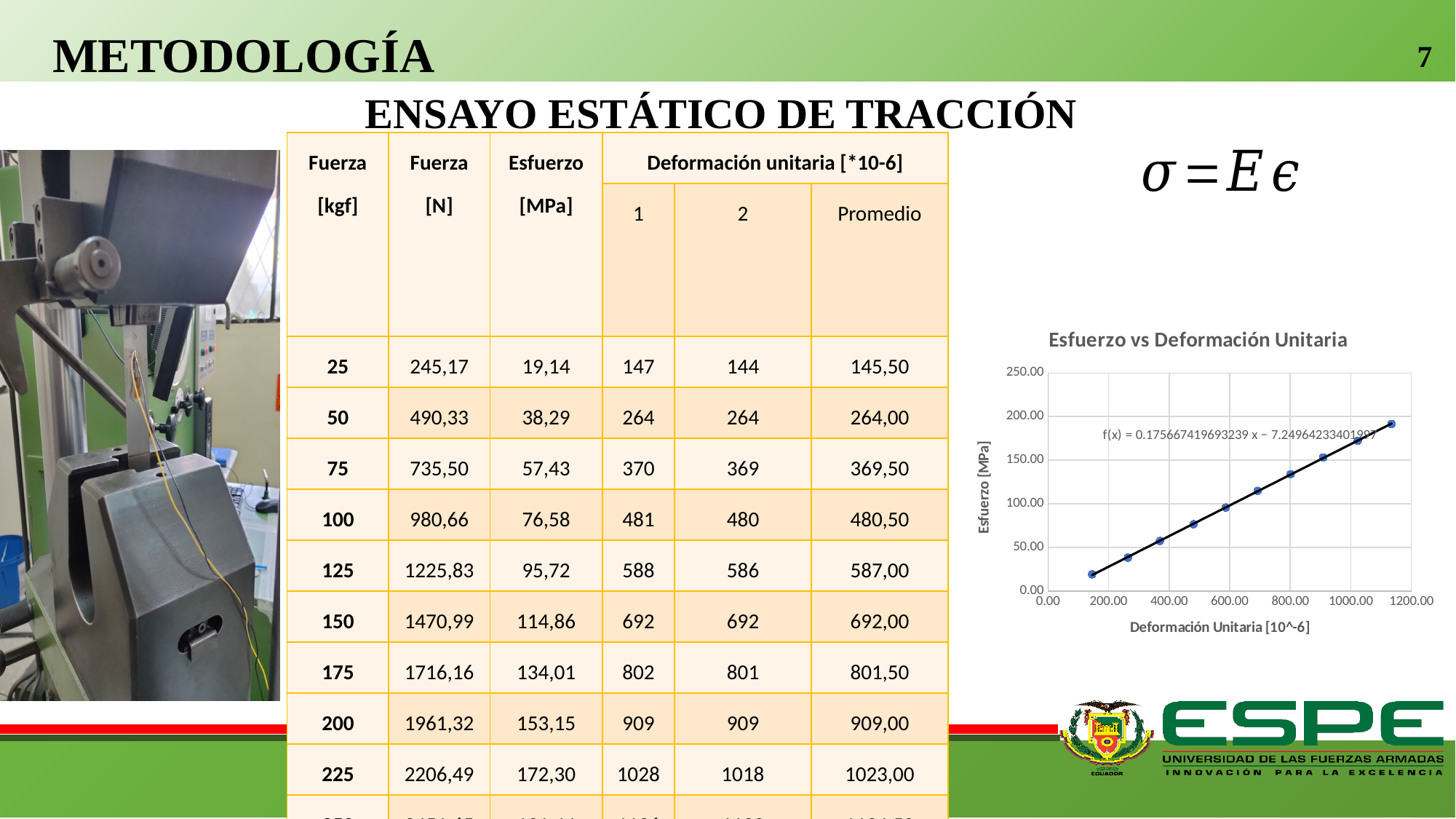
In the Esfuerzo vs Deformación Unitaria chart, is the esfuerzo of the highest point greater or less than 200? less What is the highest tick value shown on the vertical axis of the Esfuerzo vs Deformación Unitaria chart? 250.00 In the Esfuerzo vs Deformación Unitaria chart, is the esfuerzo of the point near a deformación unitaria of 1000 greater or less than 150? greater What is the highest tick value shown on the horizontal axis of the Esfuerzo vs Deformación Unitaria chart? 1200.00 What kind of chart is shown on the right of the slide? scatter chart How many data points are plotted in the Esfuerzo vs Deformación Unitaria chart? 10 What is the label of the vertical axis in the Esfuerzo vs Deformación Unitaria chart? Esfuerzo [MPa] In the Esfuerzo vs Deformación Unitaria chart, do the values rise or fall as the deformación unitaria increases? rise In the Esfuerzo vs Deformación Unitaria chart, is the esfuerzo of the lowest point greater or less than 50? less What is the title of the chart on the right of the slide? Esfuerzo vs Deformación Unitaria